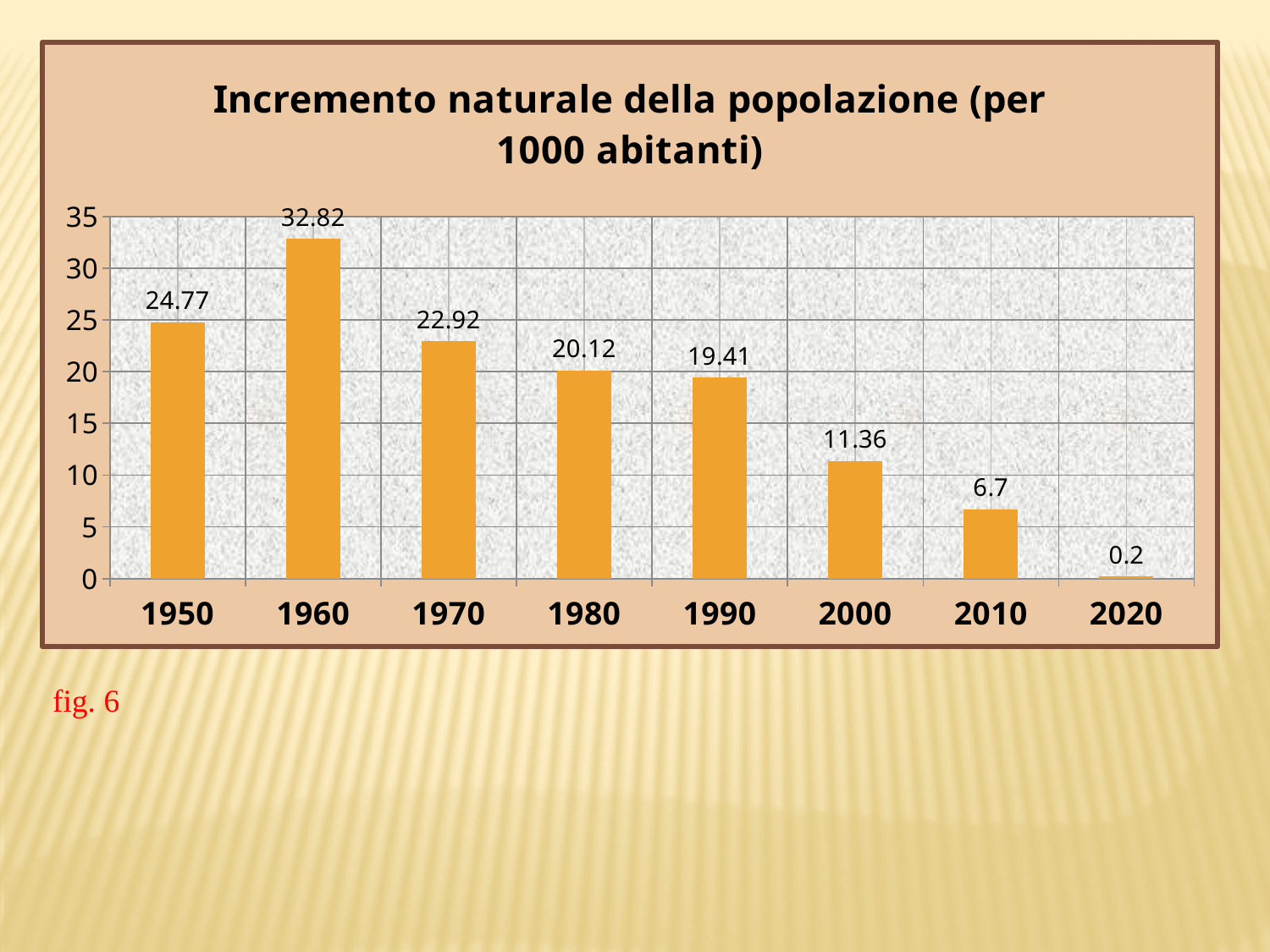
Which is larger, the value for 1970 or the value for 1980? 1970 How many years are shown on the x axis? 8 What is the value for 2000? 11.36 Which year has the highest value? 1960 Do the values rise or fall from 1960 to 2020? fall What is the value for 2020? 0.2 What is the difference between the values for 1960 and 1950? 8.05 What is the difference between the values for 2000 and 2010? 4.66 Which year has the lowest value? 2020 What kind of chart is this? bar chart What is the value for 1960? 32.82 Is the value for 1990 greater or less than 20? less